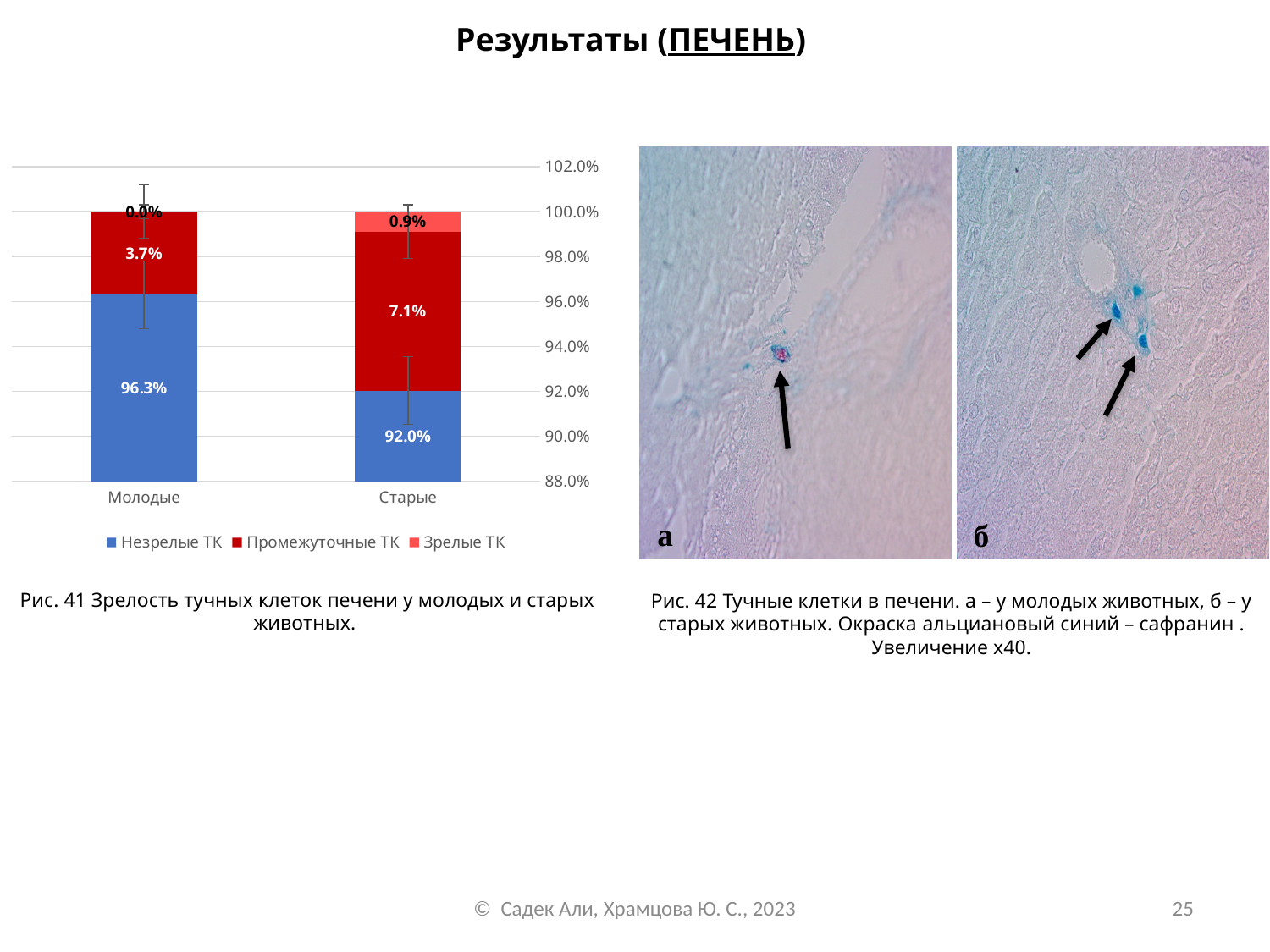
What is the value of Промежуточные ТК for Молодые? 3.7% What is the value of Незрелые ТК for Молодые? 96.3% What is the value of Зрелые ТК for Старые? 0.9% Which series is shown in blue in the legend? Незрелые ТК What is the value of Промежуточные ТК for Старые? 7.1% How many categories are shown on the x axis? 2 Which category has the higher value for Незрелые ТК, Молодые or Старые? Молодые What is the difference between the Незрелые ТК values for Молодые and Старые? 4.3% What type of chart is shown on the slide? Stacked bar chart What is the value of Зрелые ТК for Молодые? 0.0% How many series does the legend list? 3 What is the value of Незрелые ТК for Старые? 92.0%